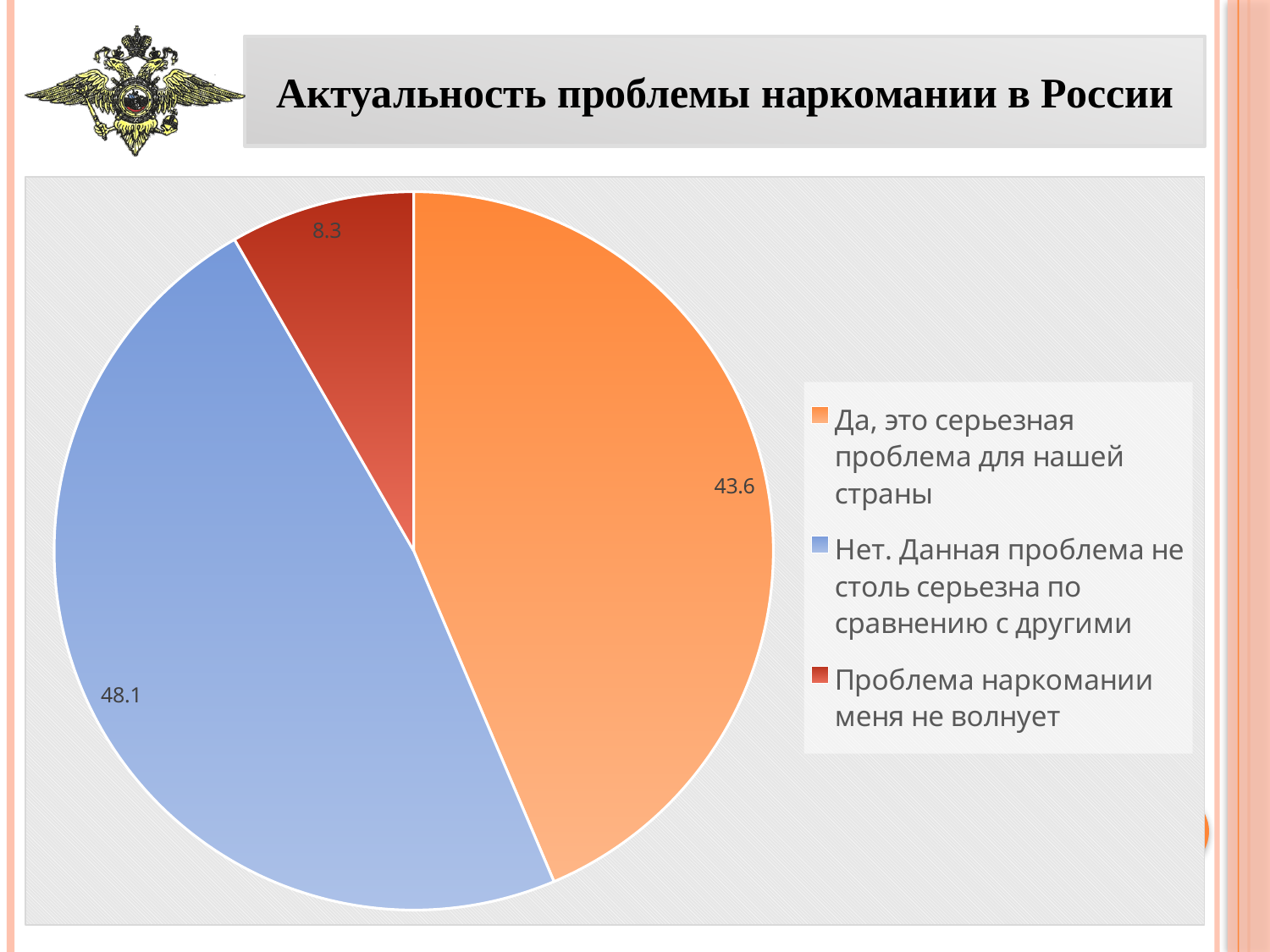
How many slices does the pie chart have? 3 What is the title of the slide containing the chart? Актуальность проблемы наркомании в России What colour is the slice for "Нет. Данная проблема не столь серьезна по сравнению с другими"? blue What is the value for the slice "Да, это серьезная проблема для нашей страны"? 43.6 What is the difference between the values for "Да, это серьезная проблема для нашей страны" and "Проблема наркомании меня не волнует"? 35.3 Which category has the largest slice of the pie? Нет. Данная проблема не столь серьезна по сравнению с другими Which is larger: the value for "Да, это серьезная проблема для нашей страны" or the value for "Проблема наркомании меня не волнует"? Да, это серьезная проблема для нашей страны Which category has the smallest slice of the pie? Проблема наркомании меня не волнует What is the value for the slice "Проблема наркомании меня не волнует"? 8.3 What is the value for the slice "Нет. Данная проблема не столь серьезна по сравнению с другими"? 48.1 What is the difference between the values for "Нет. Данная проблема не столь серьезна по сравнению с другими" and "Да, это серьезная проблема для нашей страны"? 4.5 What type of chart is shown on the slide? pie chart